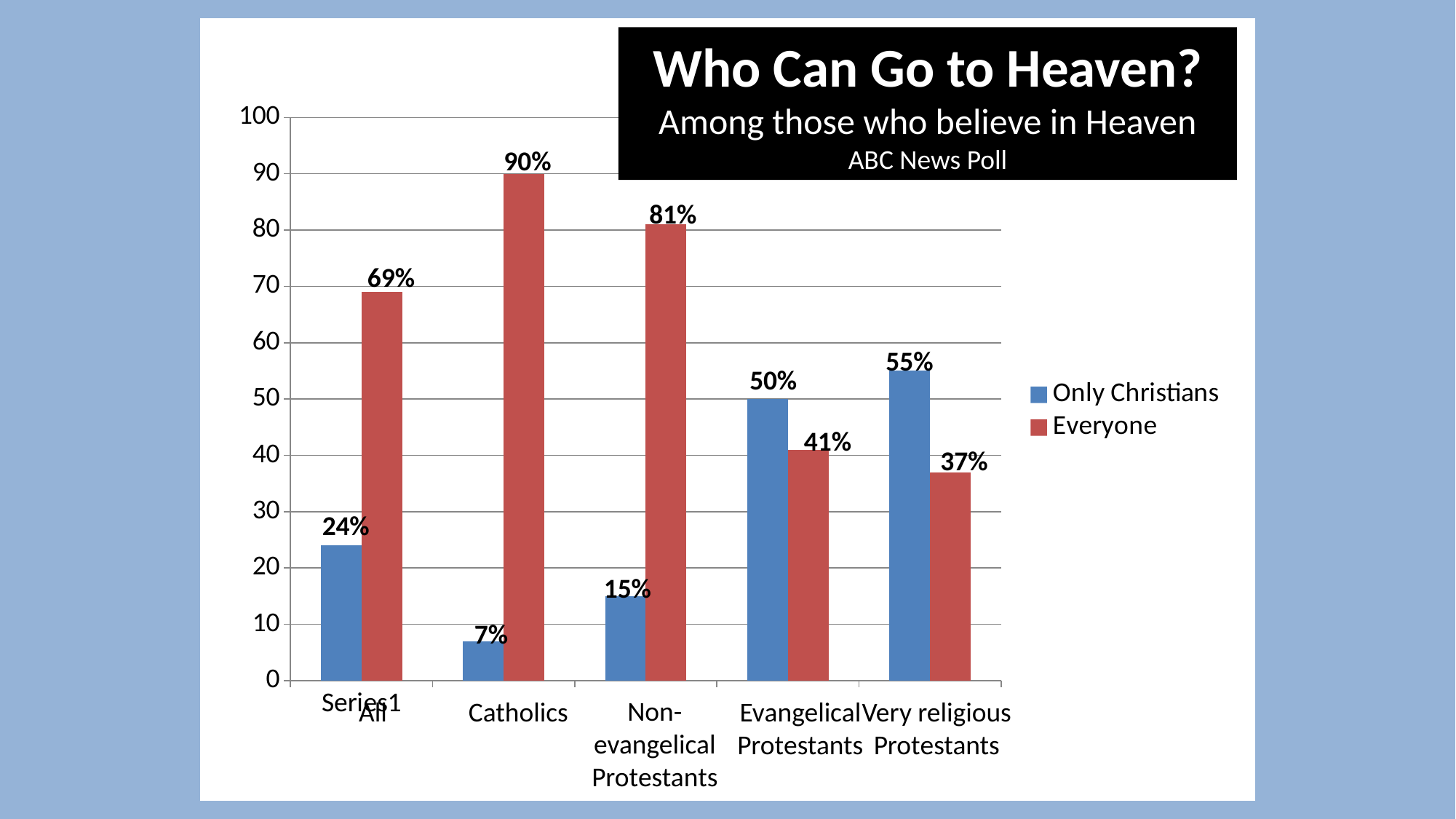
What is the value for Everyone among Non-evangelical Protestants? 81% What kind of chart is shown on the slide? Bar chart What is the value for Only Christians among Very religious Protestants? 55% How many series does the legend list? 2 How many groups are shown on the x axis? 5 What percentage of Catholics say only Christians can go to heaven? 7% Which group has the lowest value for Only Christians? Catholics What is the main title of the chart? Who Can Go to Heaven? Among Evangelical Protestants, which is larger: Only Christians or Everyone? Only Christians Which group has the highest value for Everyone? Catholics Which colour represents the Everyone series? Red What is the difference between the Everyone and Only Christians values for the All group? 45%